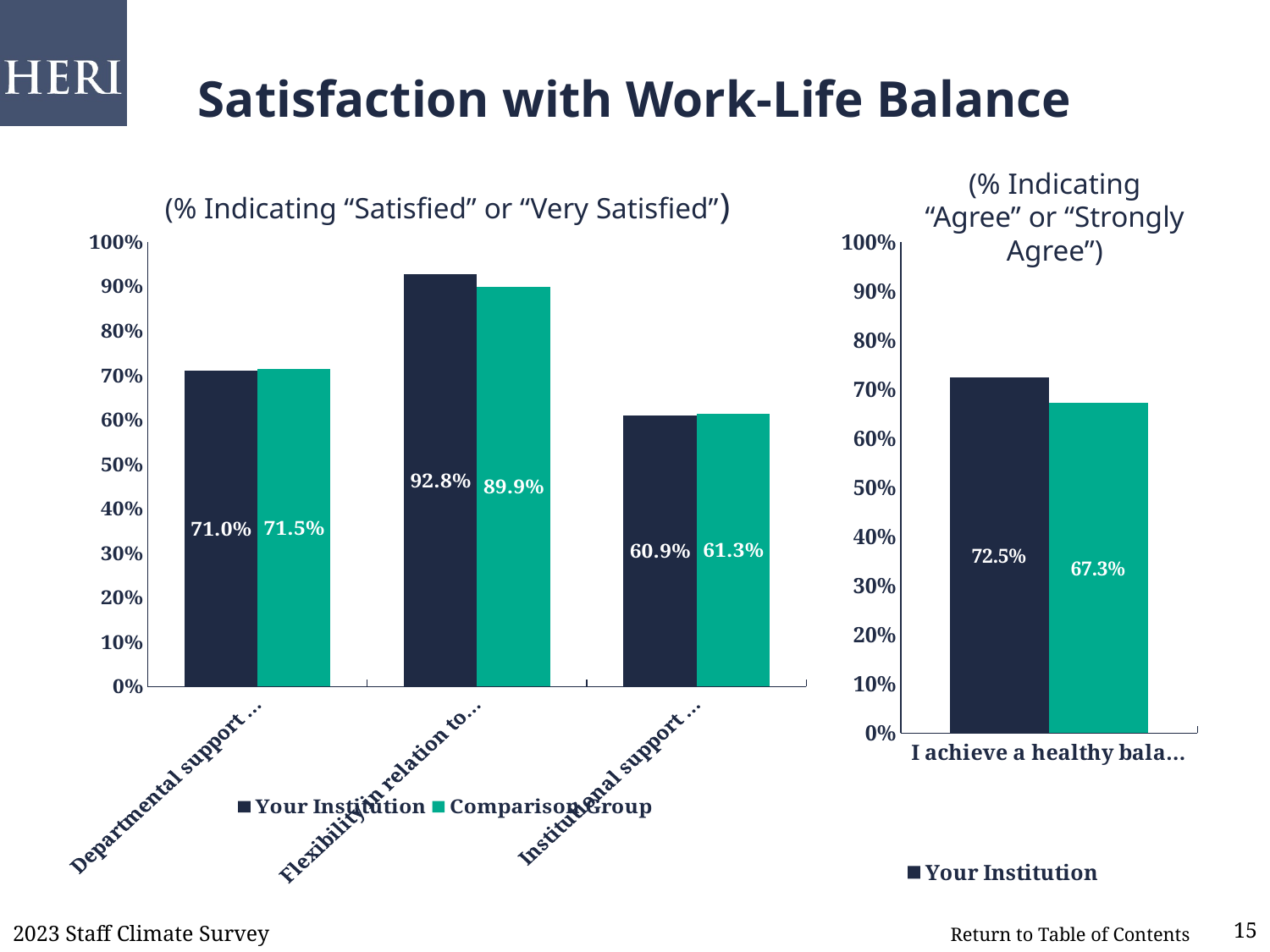
On the left chart (% Indicating "Satisfied" or "Very Satisfied"), what is the Your Institution value for the "Institutional support ..." category? 60.9% On the left chart (% Indicating "Satisfied" or "Very Satisfied"), how many categories are shown on the x axis? 3 On the left chart (% Indicating "Satisfied" or "Very Satisfied"), what is the value for Your Institution in the "Flexibility in relation to..." category? 92.8% On the left chart (% Indicating "Satisfied" or "Very Satisfied"), which category has the highest Your Institution value? Flexibility in relation to... On the left chart (% Indicating "Satisfied" or "Very Satisfied"), which category has the lowest Comparison Group value? Institutional support ... On the right chart (% Indicating "Agree" or "Strongly Agree"), what is the difference between the dark blue bar (72.5%) and the teal bar (67.3%)? 5.2% On the right chart (% Indicating "Agree" or "Strongly Agree"), which series name does the legend list? Your Institution On the right chart (% Indicating "Agree" or "Strongly Agree"), what is the value for Your Institution for "I achieve a healthy bala..."? 72.5% What kind of chart is the right chart (% Indicating "Agree" or "Strongly Agree")? Bar chart On the left chart (% Indicating "Satisfied" or "Very Satisfied"), what is the Comparison Group value for the "Departmental support ..." category? 71.5% On the left chart (% Indicating "Satisfied" or "Very Satisfied"), how many series does the legend list? 2 On the left chart (% Indicating "Satisfied" or "Very Satisfied"), what is the difference between the Your Institution and Comparison Group values in the "Flexibility in relation to..." category? 2.9%